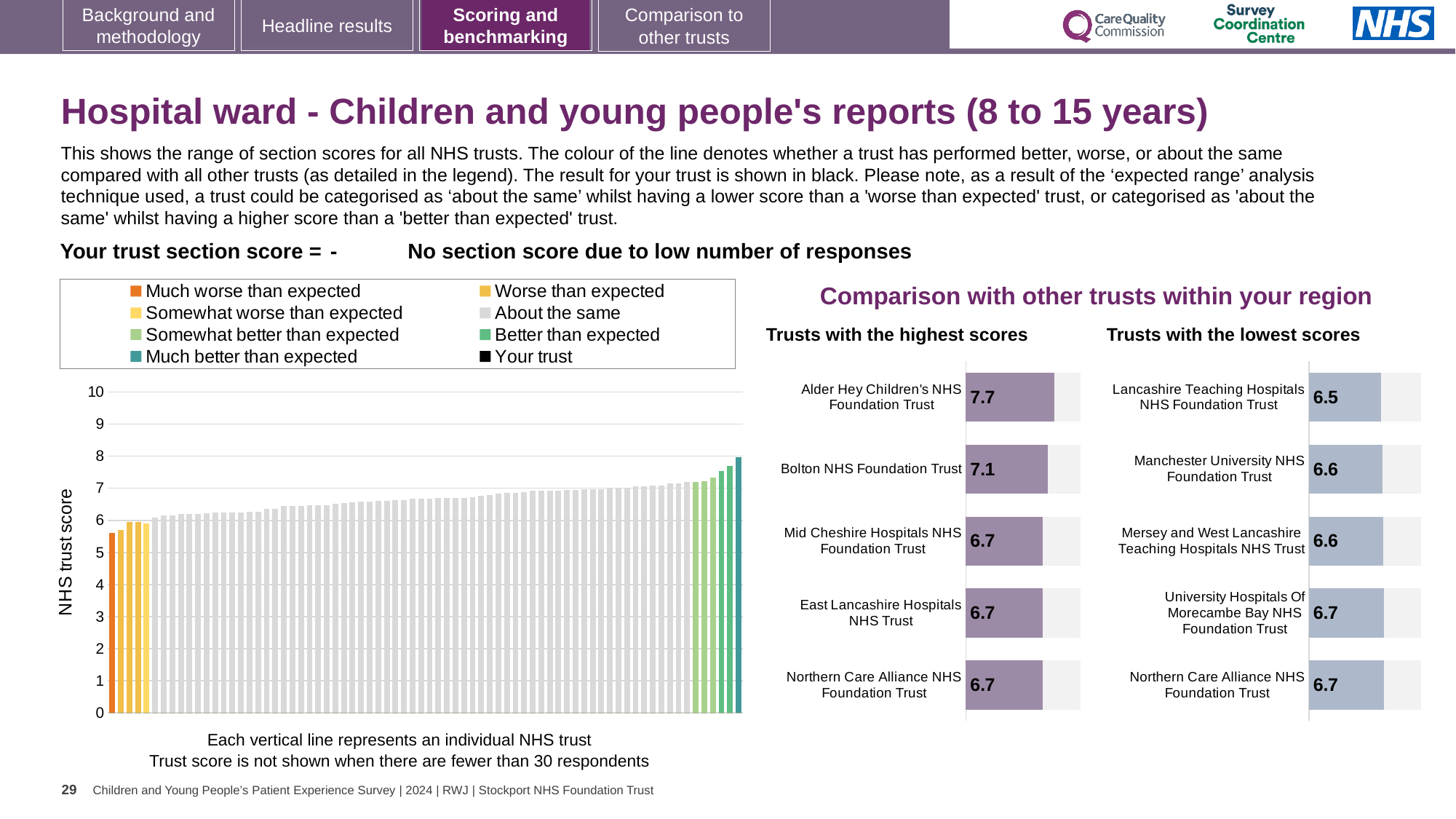
How many trusts are listed in the 'Trusts with the lowest scores' chart? 5 In the 'Trusts with the highest scores' chart, which trust has the highest score? Alder Hey Children's NHS Foundation Trust In the 'Trusts with the lowest scores' chart, what is the score for Lancashire Teaching Hospitals NHS Foundation Trust? 6.5 In the 'Trusts with the highest scores' chart, what is the score for Alder Hey Children's NHS Foundation Trust? 7.7 In the 'Trusts with the highest scores' chart, which has the larger score: Bolton NHS Foundation Trust or Mid Cheshire Hospitals NHS Foundation Trust? Bolton NHS Foundation Trust In the 'NHS trust score' chart on the left, is the value of the leftmost (orange) bar greater or less than 6? less What type of chart is the 'NHS trust score' chart on the left of the slide? Bar chart In the 'Trusts with the highest scores' chart, what is the difference between the scores of Alder Hey Children's NHS Foundation Trust and Bolton NHS Foundation Trust? 0.6 In the 'Trusts with the lowest scores' chart, which trust has the lowest score? Lancashire Teaching Hospitals NHS Foundation Trust In the 'Trusts with the lowest scores' chart, what is the score for Manchester University NHS Foundation Trust? 6.6 In the 'Trusts with the lowest scores' chart, what is the difference between the scores of Northern Care Alliance NHS Foundation Trust and Lancashire Teaching Hospitals NHS Foundation Trust? 0.2 In the 'Trusts with the highest scores' chart, what is the score for Bolton NHS Foundation Trust? 7.1